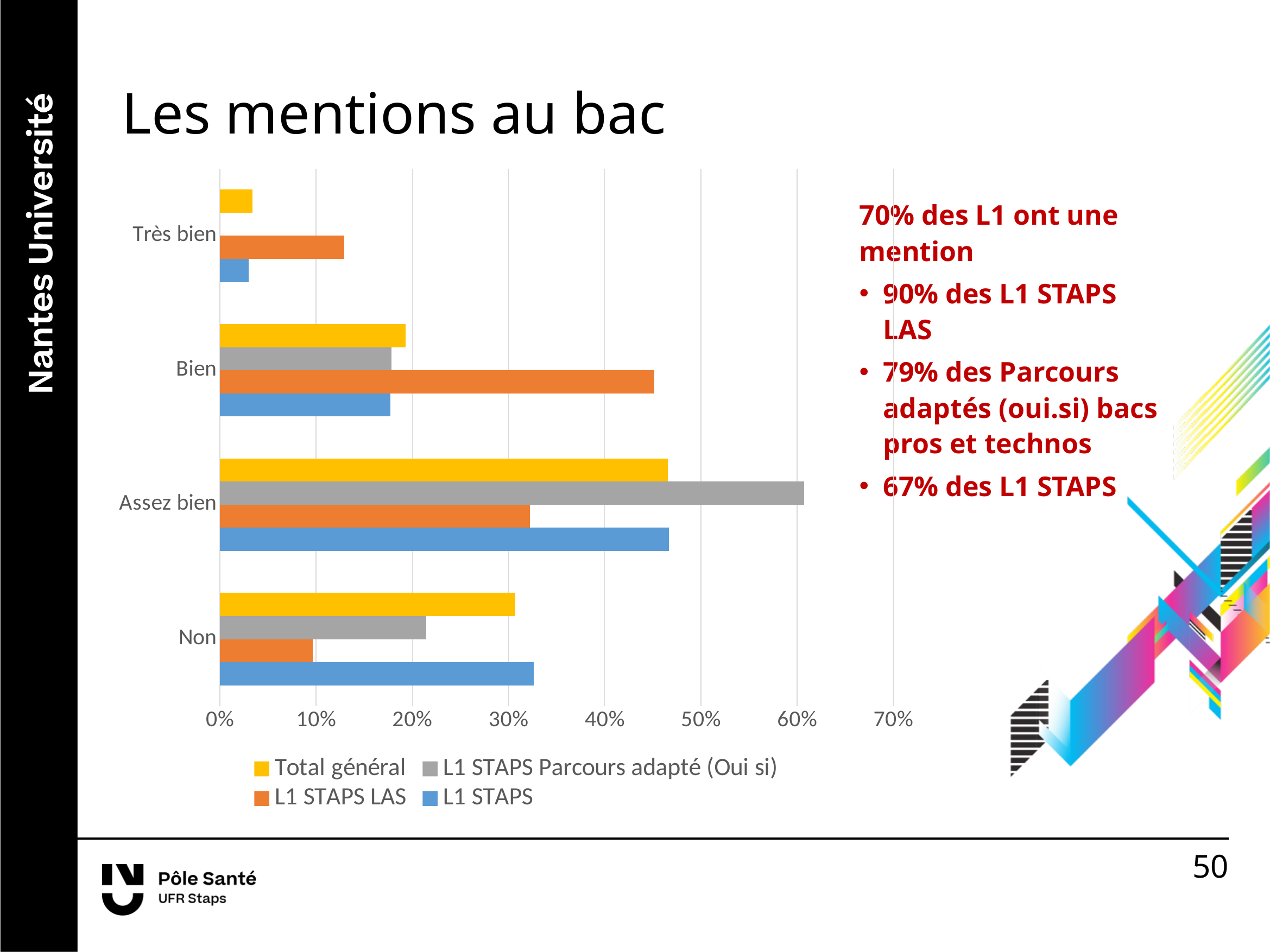
In the Bien category, which is larger: L1 STAPS LAS or L1 STAPS? L1 STAPS LAS Is the value for L1 STAPS Parcours adapté (Oui si) in the Assez bien category greater or less than 50%? greater How many categories are shown on the vertical axis of the chart? 4 Which series has the highest value in the Assez bien category? L1 STAPS Parcours adapté (Oui si) Which category has the lowest value for Total général? Très bien In the Non category, which is larger: L1 STAPS or L1 STAPS LAS? L1 STAPS Is the value for Total général in the Assez bien category greater or less than 40%? greater How many series does the chart legend list? 4 Is the value for L1 STAPS LAS in the Bien category greater or less than 40%? greater What kind of chart is shown on the slide? bar chart Which category has the highest value for L1 STAPS Parcours adapté (Oui si)? Assez bien